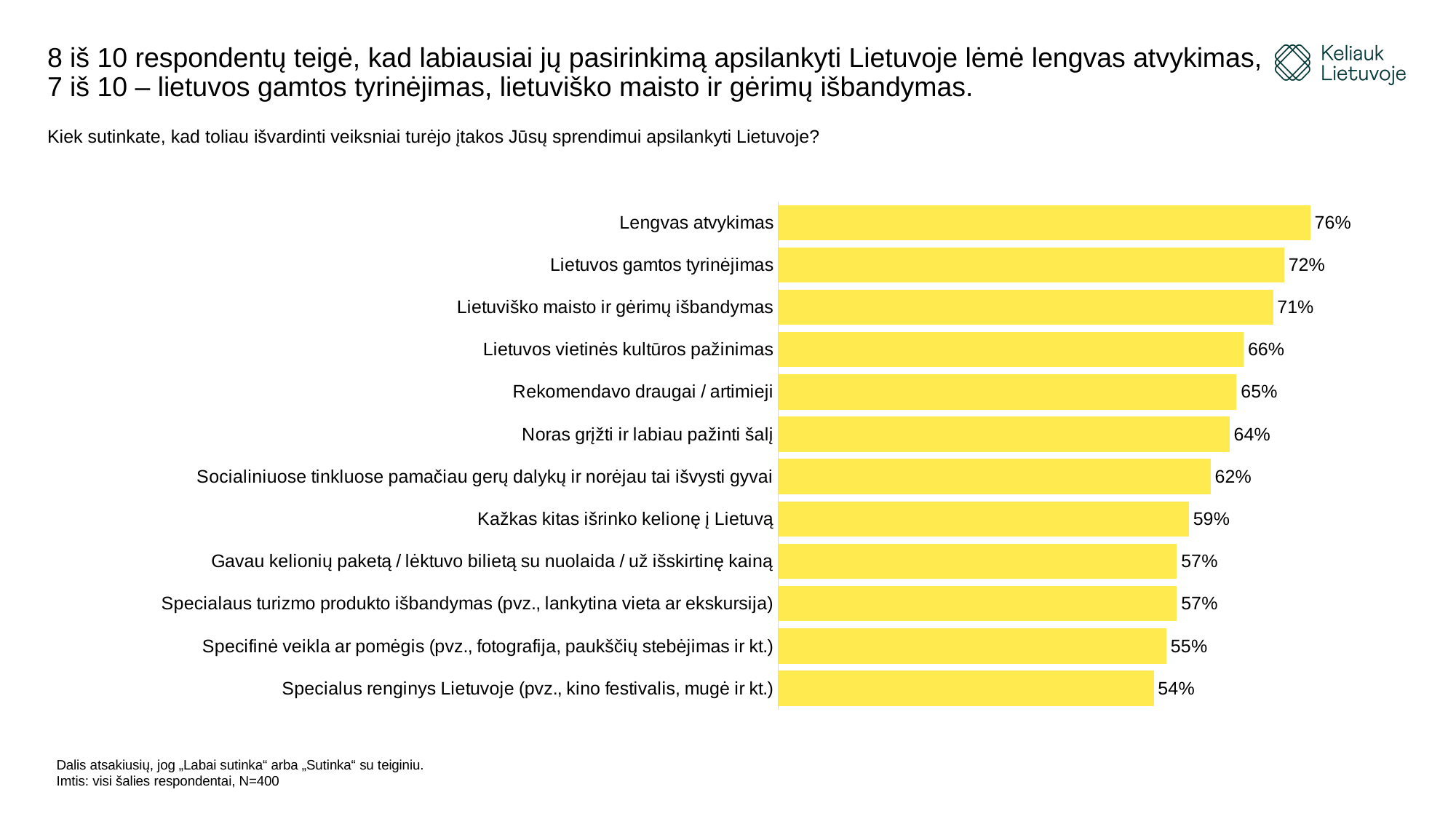
Which is larger: the value for "Noras grįžti ir labiau pažinti šalį" or the value for "Specifinė veikla ar pomėgis (pvz., fotografija, paukščių stebėjimas ir kt.)"? Noras grįžti ir labiau pažinti šalį What is the difference between the values for "Lietuvos vietinės kultūros pažinimas" and "Specialus renginys Lietuvoje (pvz., kino festivalis, mugė ir kt.)"? 12% What value is shown for "Rekomendavo draugai / artimieji"? 65% What is the difference between the values for "Lengvas atvykimas" and "Lietuvos gamtos tyrinėjimas"? 4% What kind of chart is shown on the slide? Bar chart Which category has the lowest value? Specialus renginys Lietuvoje (pvz., kino festivalis, mugė ir kt.) Which category has the highest value? Lengvas atvykimas Which two categories share the same value of 57%? Gavau kelionių paketą / lėktuvo bilietą su nuolaida / už išskirtinę kainą; Specialaus turizmo produkto išbandymas (pvz., lankytina vieta ar ekskursija) What value is shown for "Kažkas kitas išrinko kelionę į Lietuvą"? 59% What colour are the bars in the chart? Yellow What value is shown for "Lengvas atvykimas"? 76% How many categories are shown in the chart? 12